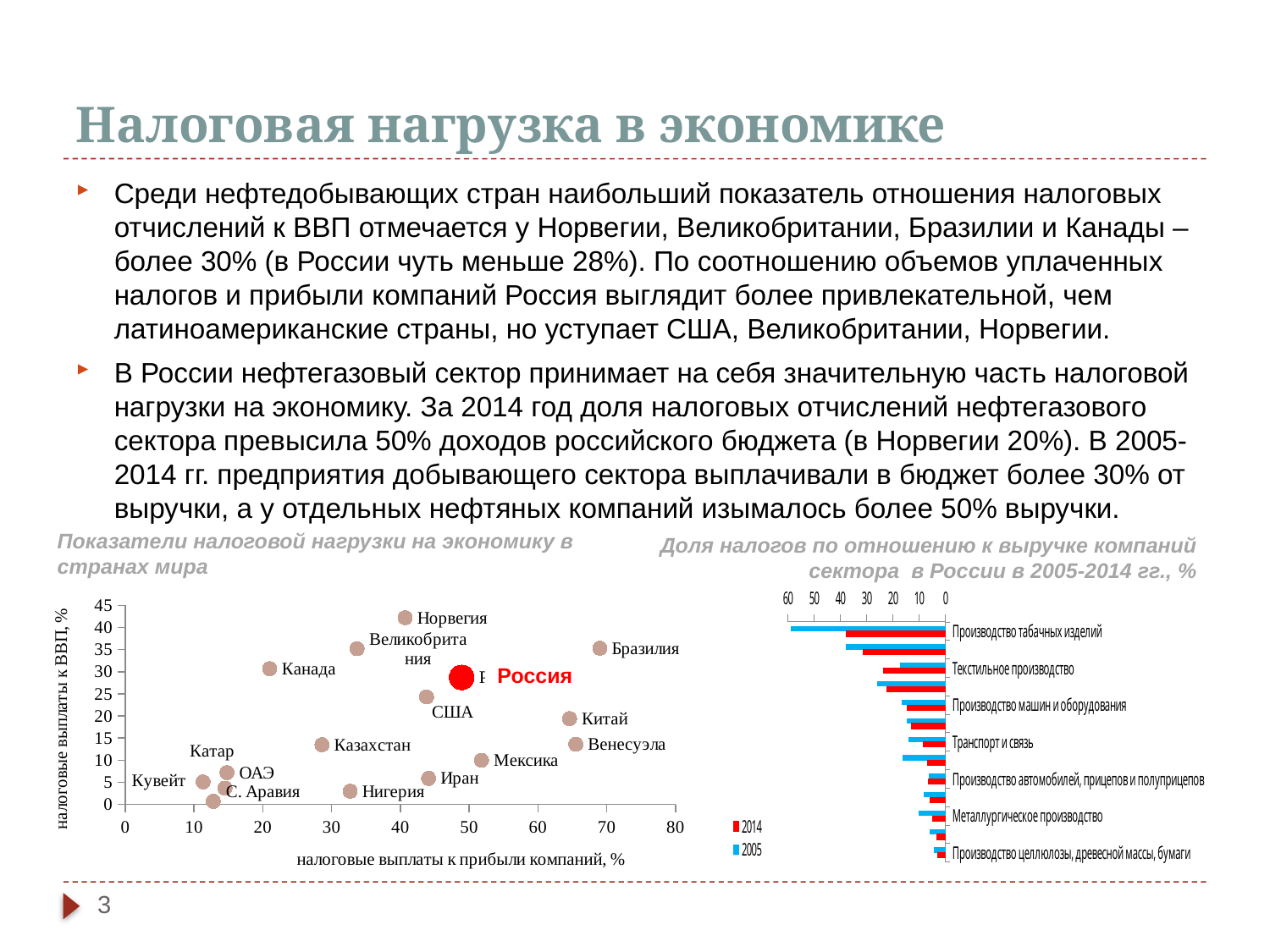
In the left scatter chart, is the value of налоговые выплаты к прибыли компаний for Канада greater or less than 30? less How many series does the legend of the right bar chart list? 2 In the right bar chart, which category has the longest bar? Производство табачных изделий In the right bar chart, is the 2005 value for Производство табачных изделий greater or less than 50? greater What kind of chart is the right chart, 'Доля налогов по отношению к выручке компаний сектора в России в 2005-2014 гг., %'? Bar chart In the left scatter chart, which country has the highest value of налоговые выплаты к ВВП, %? Норвегия In the left scatter chart, which has the higher value of налоговые выплаты к прибыли компаний: Бразилия or Казахстан? Бразилия In the left scatter chart, is the value of налоговые выплаты к прибыли компаний for Бразилия greater or less than 60? greater In the left scatter chart, which has the higher value of налоговые выплаты к ВВП: Норвегия or Канада? Норвегия What kind of chart is the left chart, 'Показатели налоговой нагрузки на экономику в странах мира'? Scatter chart